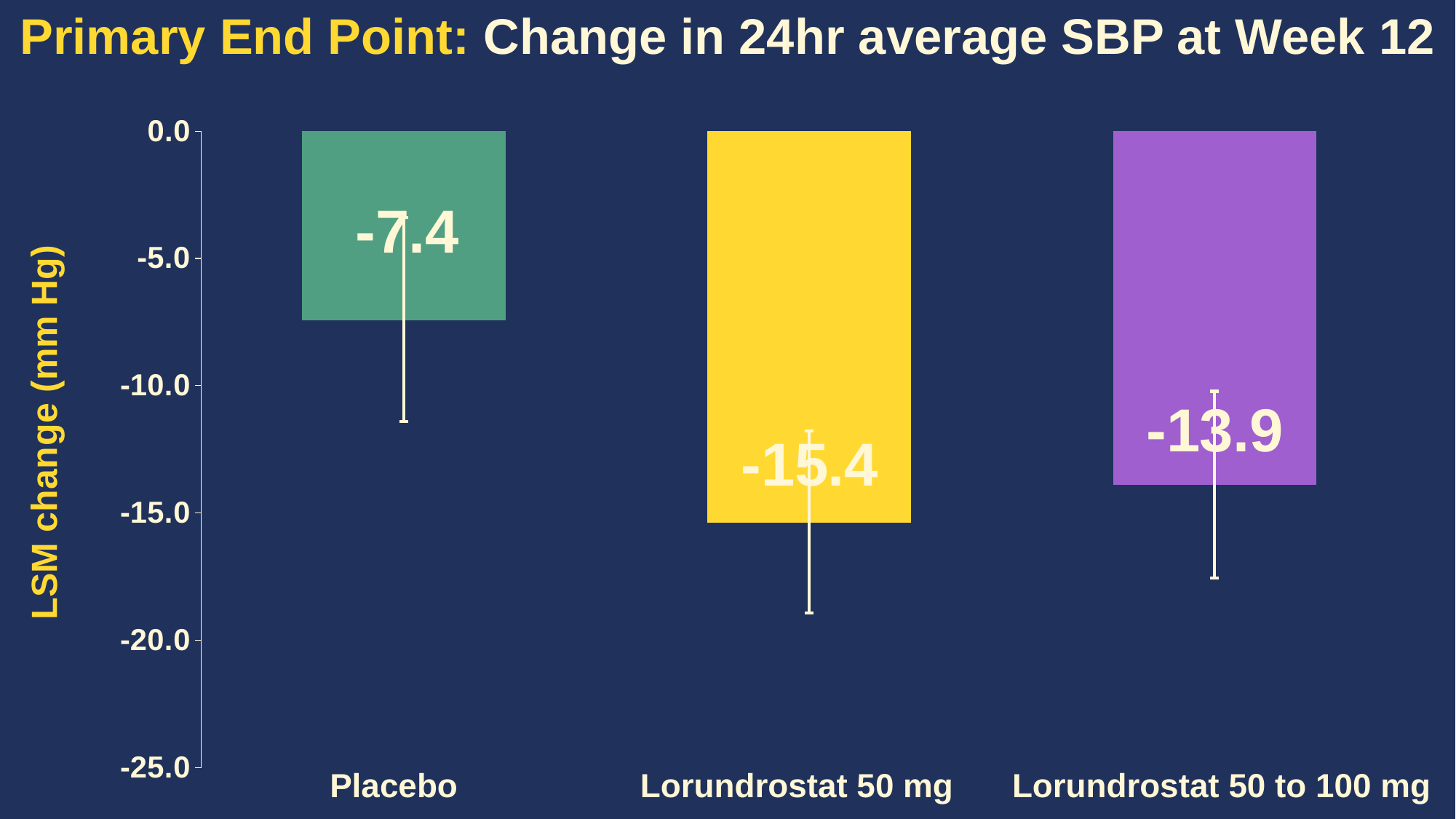
How many treatment groups are shown in the chart? 3 What is the difference between the LSM change for Lorundrostat 50 mg and Lorundrostat 50 to 100 mg? 1.5 What is the label of the y-axis? LSM change (mm Hg) What is the LSM change in 24hr average SBP for Lorundrostat 50 to 100 mg? -13.9 Which group shows the smallest reduction in 24hr average SBP? Placebo What is the LSM change in 24hr average SBP for Placebo? -7.4 What kind of chart is shown on the slide? Bar chart What is the difference between the LSM change for Lorundrostat 50 mg and Placebo? 8.0 What colour is the bar for Lorundrostat 50 mg? Yellow What is the LSM change in 24hr average SBP for Lorundrostat 50 mg? -15.4 Which group had a greater reduction in SBP: Lorundrostat 50 to 100 mg or Placebo? Lorundrostat 50 to 100 mg Which group shows the largest reduction in 24hr average SBP? Lorundrostat 50 mg